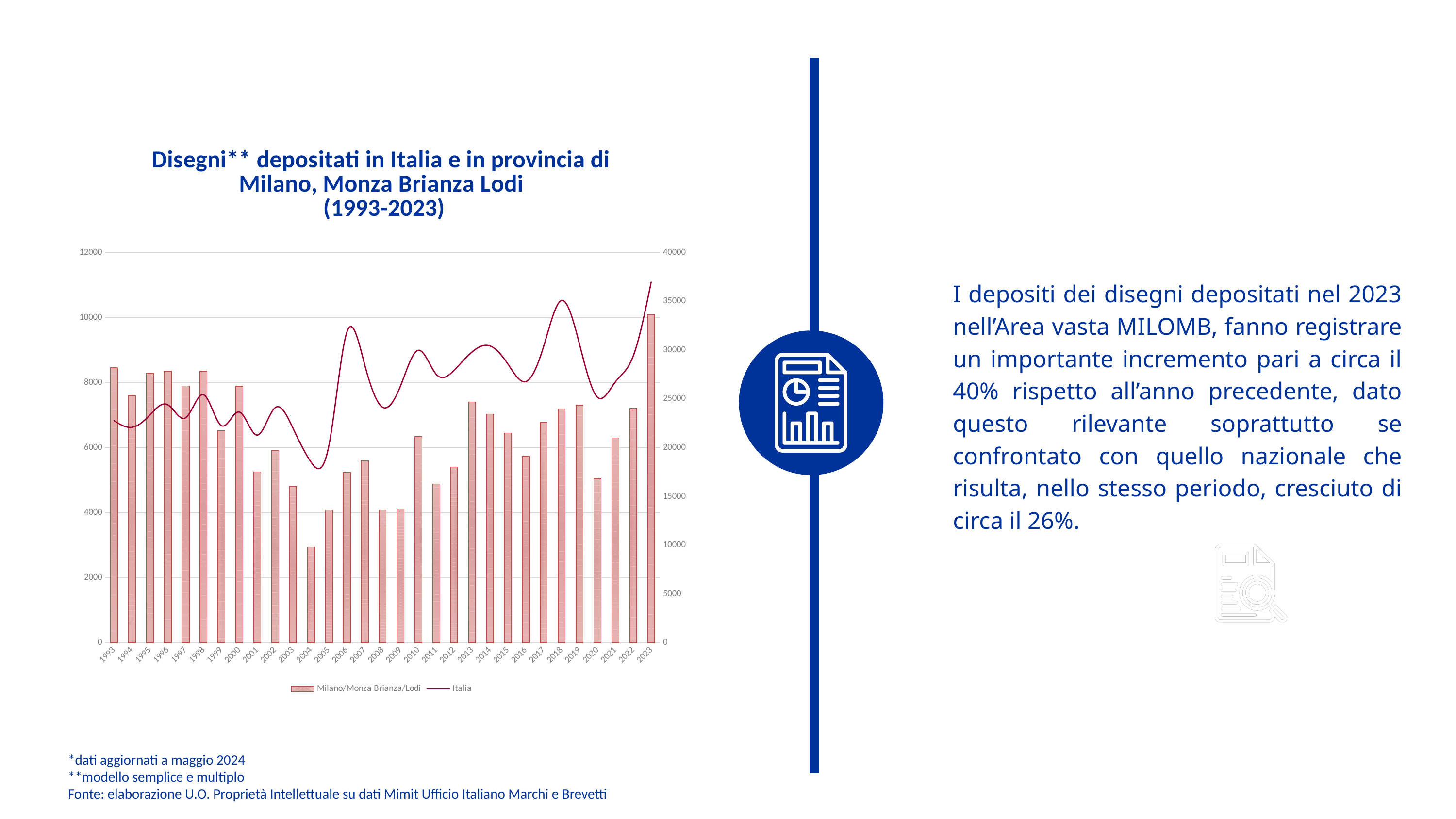
Is the Milano/Monza Brianza/Lodi value for 1993 greater or less than 8000? greater In which year does the Italia line reach its highest point? 2023 In which year does the Italia line reach its lowest point? 2004 How many years are plotted along the x axis? 31 Which year has the larger Milano/Monza Brianza/Lodi bar, 2022 or 2023? 2023 Is the Italia value for 2004 greater or less than 20000 on the right axis? less Is the Milano/Monza Brianza/Lodi value for 2004 greater or less than 4000? less Which series is drawn as bars? Milano/Monza Brianza/Lodi In which year is the Milano/Monza Brianza/Lodi bar the lowest? 2004 What kind of chart is shown on the slide? A combined bar and line chart In which year is the Milano/Monza Brianza/Lodi bar the highest? 2023 How many series does the legend list? 2